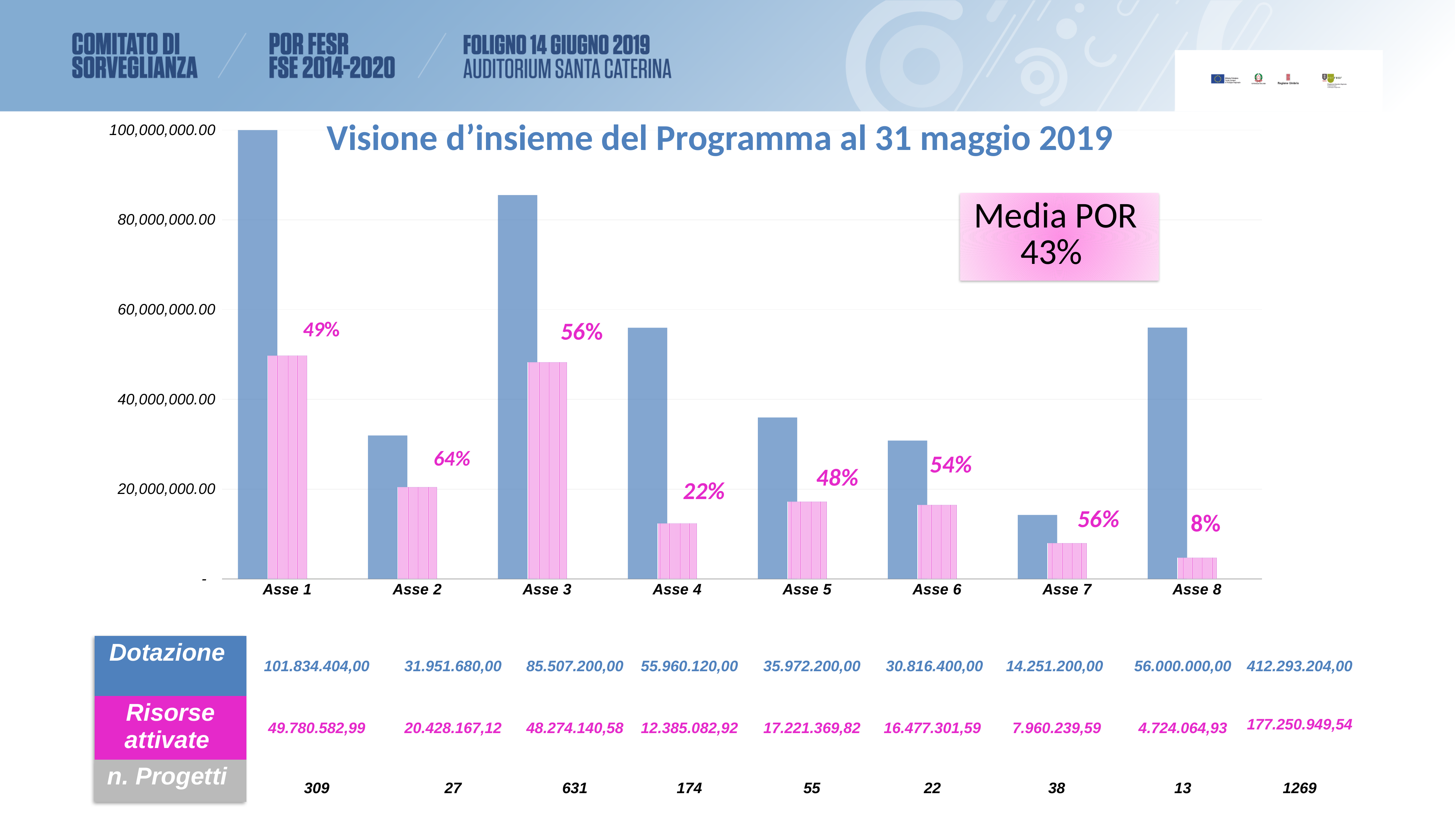
What is the difference between the Dotazione of Asse 1 and Asse 2? 69.882.724,00 Which has the larger Dotazione, Asse 5 or Asse 6? Asse 5 How many Assi (categories) are shown on the x axis of the chart? 8 Which Asse has the lowest Risorse attivate? Asse 8 How many data series does the chart plot? 2 What kind of chart is shown on the slide? bar chart Which Asse has the highest Dotazione? Asse 1 What is the Risorse attivate value for Asse 5? 17.221.369,82 Which Asse has the lowest Dotazione? Asse 7 What is the Dotazione value for Asse 3? 85.507.200,00 Is the Dotazione bar for Asse 7 greater or less than 20,000,000.00? less What percentage label is shown above the Risorse attivate bar for Asse 4? 22%